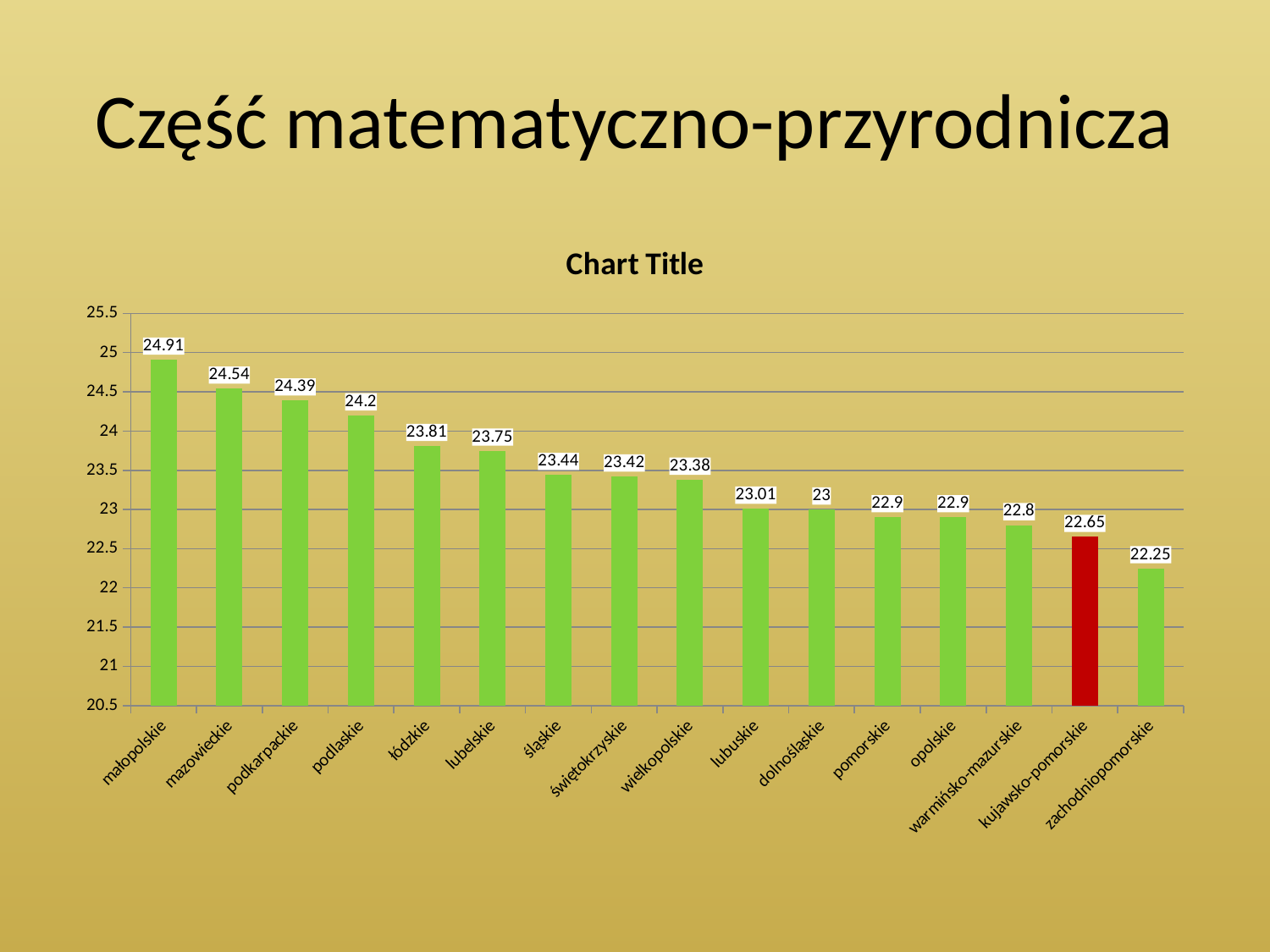
Which is larger, the value for łódzkie or the value for lubelskie? łódzkie What kind of chart is shown on the slide? bar chart What is the difference between the values for mazowieckie and podkarpackie? 0.15 What is the value for lubuskie? 23.01 How many categories are shown on the x axis? 16 What is the value for małopolskie? 24.91 Is the value for podlaskie greater or less than 24? greater What is the difference between the values for małopolskie and zachodniopomorskie? 2.66 Which category has the lowest value? zachodniopomorskie What is the value for kujawsko-pomorskie? 22.65 Which category has the highest value? małopolskie Which bar is coloured red instead of green? kujawsko-pomorskie